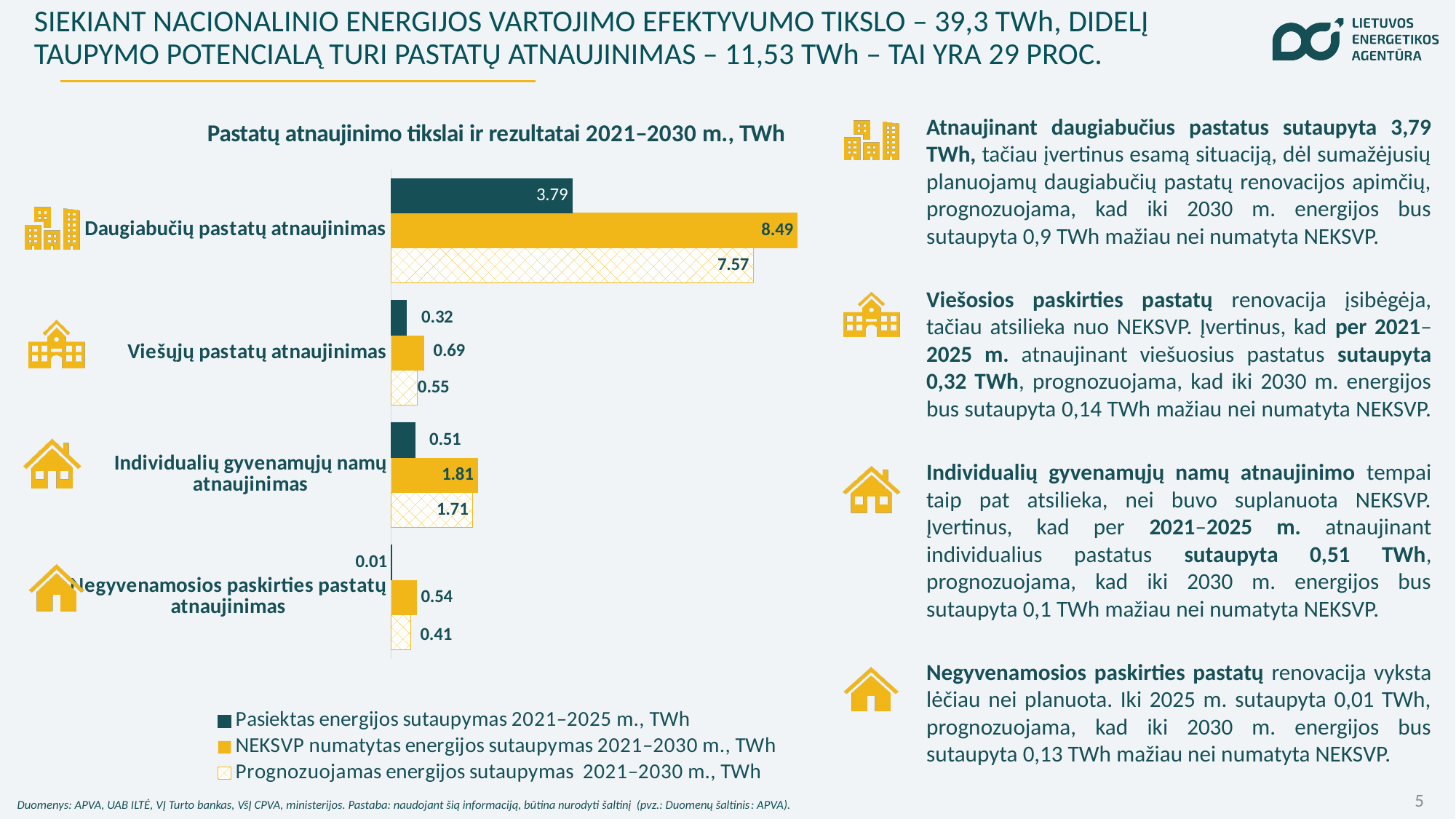
What is the value of 'Prognozuojamas energijos sutaupymas 2021–2030 m., TWh' for 'Individualių gyvenamųjų namų atnaujinimas'? 1.71 What is the value of 'Pasiektas energijos sutaupymas 2021–2025 m., TWh' for 'Negyvenamosios paskirties pastatų atnaujinimas'? 0.01 What is the title of the chart? Pastatų atnaujinimo tikslai ir rezultatai 2021–2030 m., TWh How many series does the chart legend list? 3 Which category has the highest value for 'NEKSVP numatytas energijos sutaupymas 2021–2030 m., TWh'? Daugiabučių pastatų atnaujinimas For 'Individualių gyvenamųjų namų atnaujinimas', which is larger: the 'NEKSVP numatytas' value or the 'Prognozuojamas' value? NEKSVP numatytas How many categories are plotted in the chart? 4 What kind of chart is shown on the slide? Bar chart Which category has the lowest value for 'Pasiektas energijos sutaupymas 2021–2025 m., TWh'? Negyvenamosios paskirties pastatų atnaujinimas What is the difference between the 'NEKSVP numatytas' value (8.49) and the 'Prognozuojamas' value (7.57) for 'Daugiabučių pastatų atnaujinimas'? 0.92 What is the value of 'NEKSVP numatytas energijos sutaupymas 2021–2030 m., TWh' for 'Daugiabučių pastatų atnaujinimas'? 8.49 What is the value of 'Pasiektas energijos sutaupymas 2021–2025 m., TWh' for 'Viešųjų pastatų atnaujinimas'? 0.32